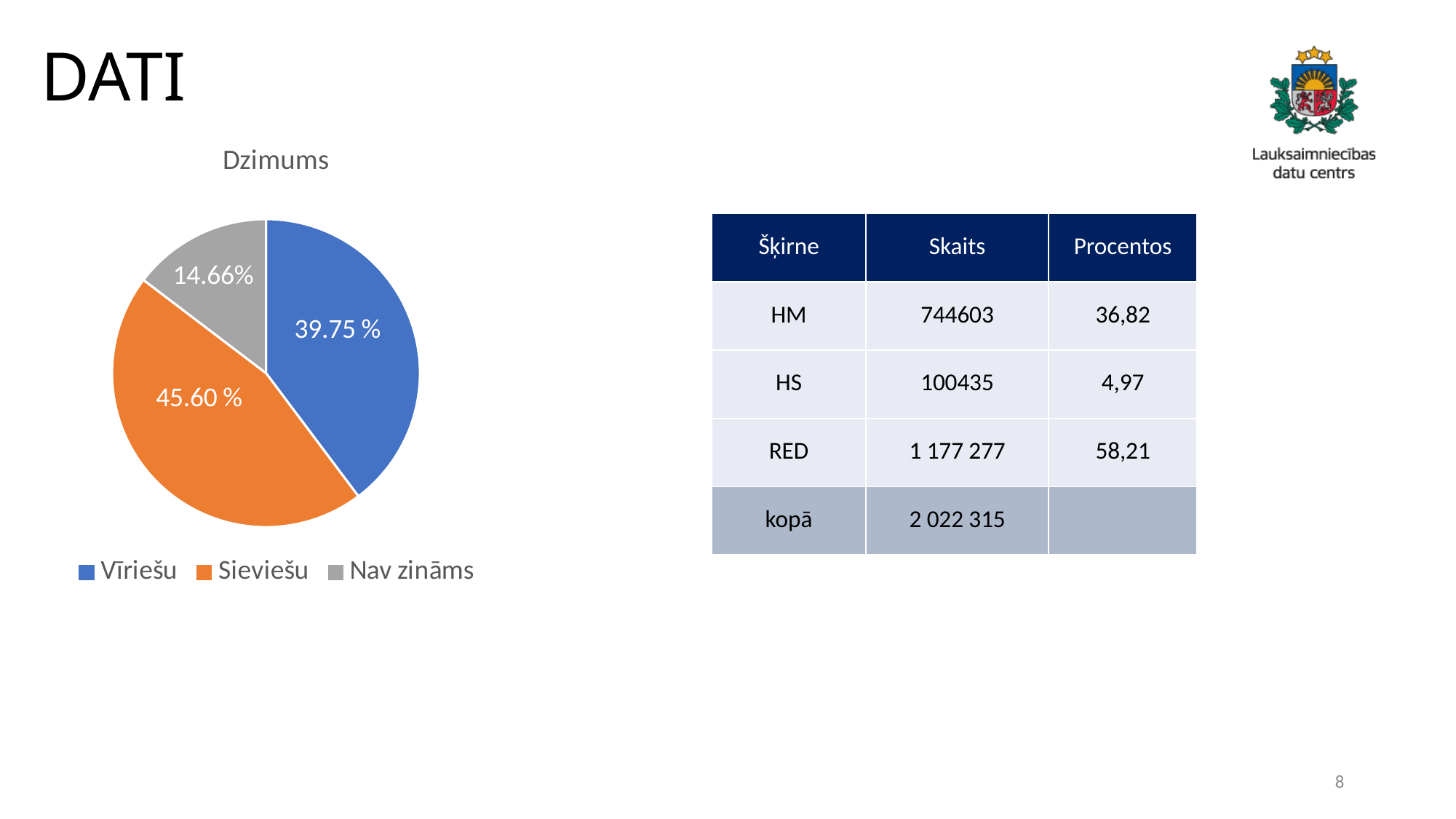
What share of the pie does Nav zināms have? 14.66% How many entries does the pie chart legend list? 3 Which is larger in the pie chart, Vīriešu or Sieviešu? Sieviešu Which category has the smallest slice of the pie? Nav zināms What share of the pie does Vīriešu have? 39.75 % What kind of chart is shown on the left of the slide? pie chart How many slices does the pie chart have? 3 What is the title of the pie chart? Dzimums What share of the pie does Sieviešu have? 45.60 % Which category has the largest slice of the pie? Sieviešu What is the difference in percentage points between the Sieviešu and Vīriešu slices? 5.85 What colour is the Sieviešu slice in the pie chart? orange